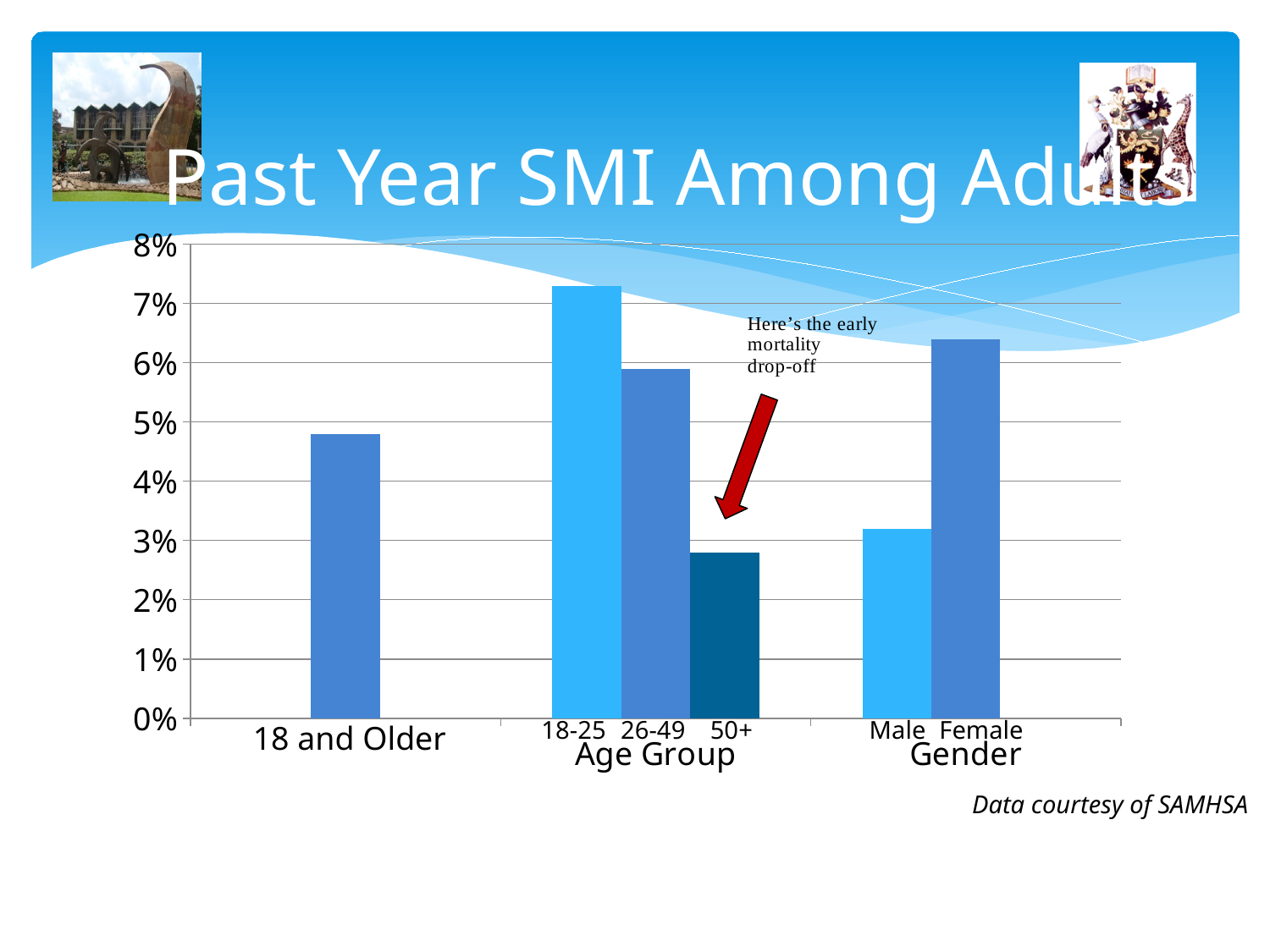
Which category has the lowest value in the chart? 50+ Is the value for 18 and Older greater or less than 4%? greater Is the value for 18-25 greater or less than 7%? greater Which category has the highest value in the chart? 18-25 What is the title of the chart? Past Year SMI Among Adults Is the value for 50+ greater or less than 3%? less Which is larger, the value for Male or the value for Female? Female What kind of chart is shown on the slide? Bar chart How many bars are plotted in the chart? 6 Which is larger, the value for 18-25 or the value for 26-49? 18-25 Which bar does the red arrow labelled 'Here's the early mortality drop-off' point to? 50+